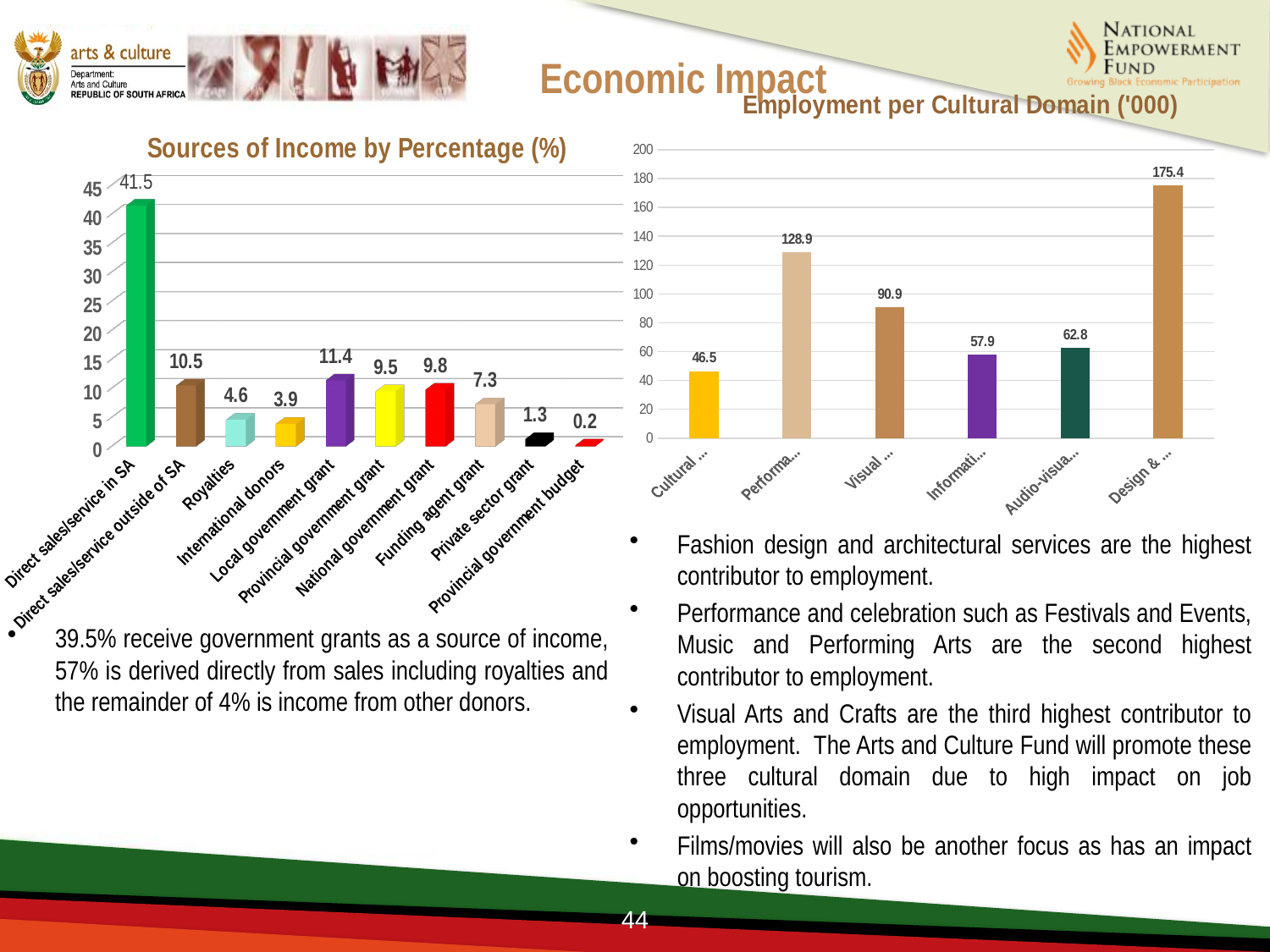
How many categories are shown in the 'Sources of Income by Percentage (%)' chart? 10 What type of chart is 'Sources of Income by Percentage (%)'? Bar chart In the 'Sources of Income by Percentage (%)' chart, what is the difference between Royalties and International donors? 0.7 In the 'Sources of Income by Percentage (%)' chart, which category has the lowest value? Provincial government budget In the 'Employment per Cultural Domain ('000)' chart, what is the value for the 'Performa...' bar? 128.9 In the 'Employment per Cultural Domain ('000)' chart, what is the difference between the 'Audio-visua...' bar and the 'Informati...' bar? 4.9 In the 'Sources of Income by Percentage (%)' chart, what is the value for Direct sales/service in SA? 41.5 How many bars are shown in the 'Employment per Cultural Domain ('000)' chart? 6 In the 'Sources of Income by Percentage (%)' chart, which is larger: Funding agent grant or Private sector grant? Funding agent grant In the 'Sources of Income by Percentage (%)' chart, which category has the highest value? Direct sales/service in SA In the 'Sources of Income by Percentage (%)' chart, what is the value for Local government grant? 11.4 In the 'Employment per Cultural Domain ('000)' chart, what is the highest value shown? 175.4